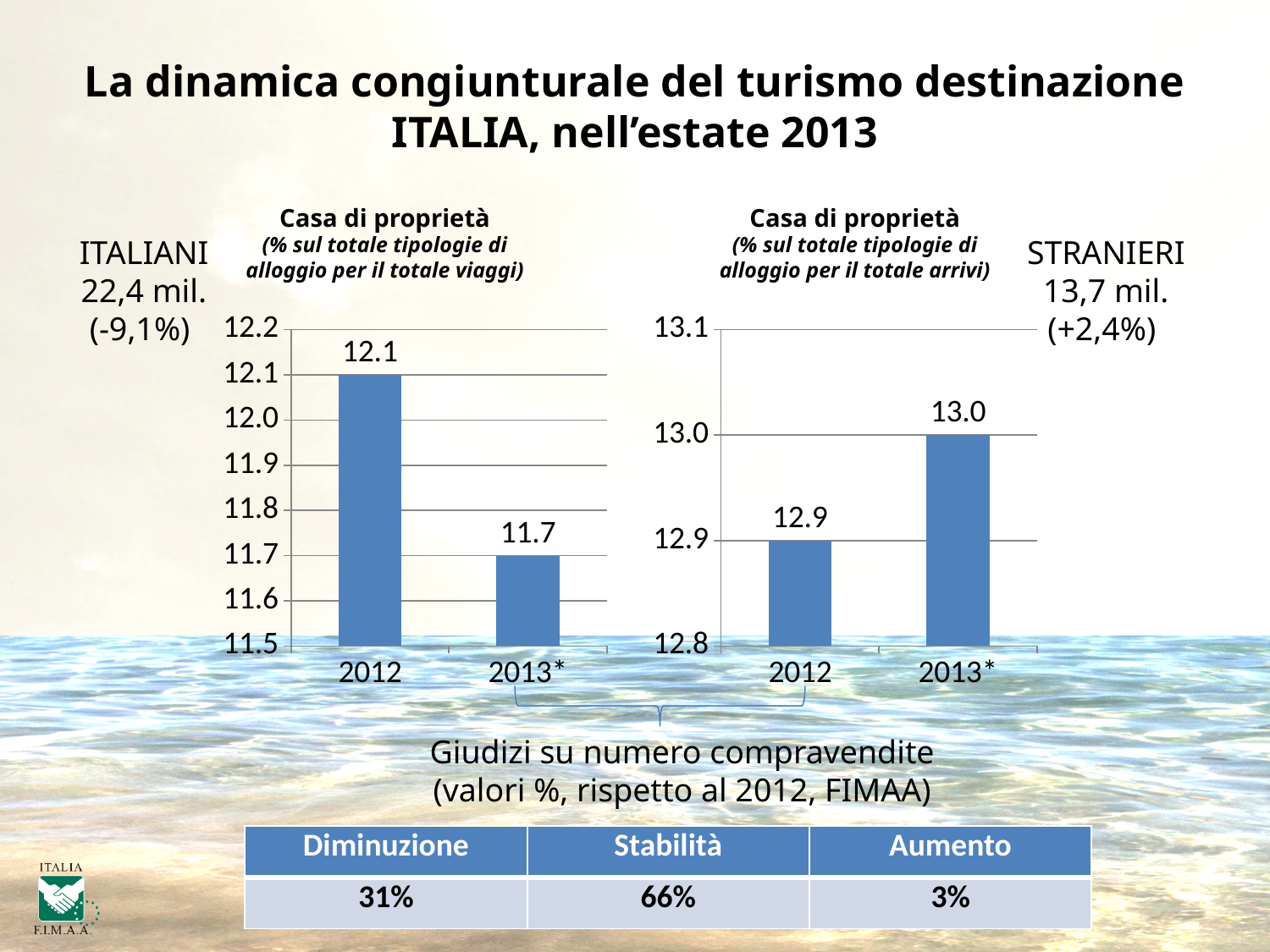
In the right chart (STRANIERI), which year has the lower value? 2012 What type of chart is the right chart (STRANIERI)? bar chart In the right chart (STRANIERI), what is the value for 2012? 12.9 In the left chart (ITALIANI), what is the difference between the 2012 and 2013* values? 0.4 In the left chart (ITALIANI), what is the value for 2012? 12.1 In the right chart (STRANIERI), do the values rise or fall from 2012 to 2013*? rise In the right chart (STRANIERI), what is the value for 2013*? 13.0 How many bars are shown in the left chart (ITALIANI)? 2 In the right chart (STRANIERI), what is the difference between the 2013* and 2012 values? 0.1 In the left chart (ITALIANI), which year has the higher value? 2012 In the left chart (ITALIANI), do the values rise or fall from 2012 to 2013*? fall In the left chart (ITALIANI), what is the value for 2013*? 11.7